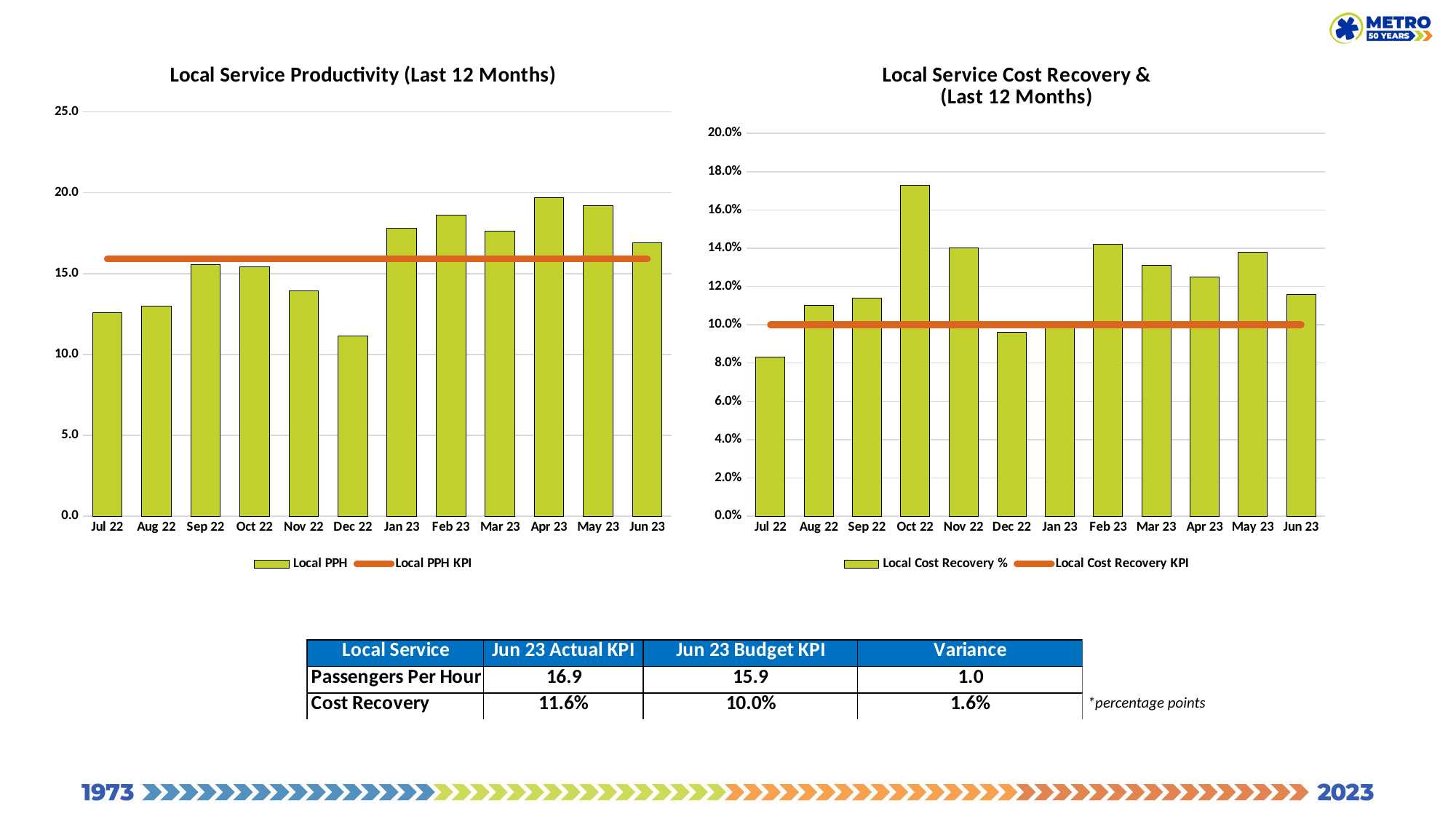
In the Local Service Productivity (Last 12 Months) chart, how many months are shown on the x axis? 12 In the Local Service Productivity (Last 12 Months) chart, which month has the lowest Local PPH bar? Dec 22 In the Local Service Cost Recovery & (Last 12 Months) chart, which month has the lowest Local Cost Recovery % bar? Jul 22 What kind of chart is the Local Service Productivity (Last 12 Months) chart? Bar chart In the Local Service Cost Recovery & (Last 12 Months) chart, which month has the highest Local Cost Recovery % bar? Oct 22 In the Local Service Cost Recovery & (Last 12 Months) chart, do the Local Cost Recovery % bars rise or fall from Jul 22 to Oct 22? rise In the Local Service Productivity (Last 12 Months) chart, which is larger, the Local PPH bar for Sep 22 or for Dec 22? Sep 22 In the Local Service Productivity (Last 12 Months) chart, is the Local PPH value for Dec 22 greater or less than 15.0? less How many series does the legend of the Local Service Productivity (Last 12 Months) chart list? 2 In the Local Service Cost Recovery & (Last 12 Months) chart, is the Local Cost Recovery % value for Oct 22 greater or less than 16.0%? greater In the Local Service Productivity (Last 12 Months) chart, which month has the highest Local PPH bar? Apr 23 What is the name of the line series in the legend of the Local Service Cost Recovery & (Last 12 Months) chart? Local Cost Recovery KPI